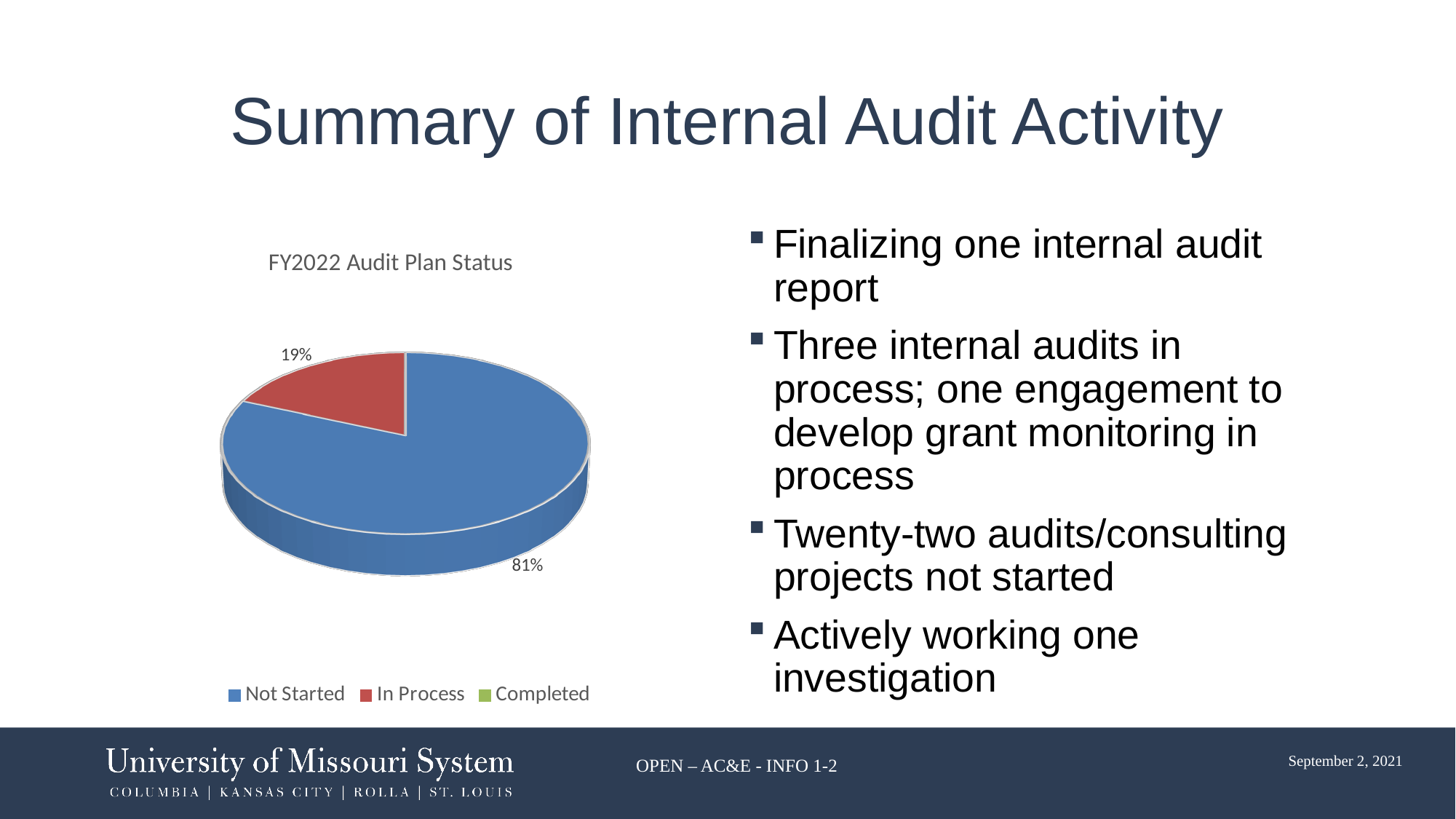
Which is larger, the Not Started slice or the In Process slice? Not Started How many entries does the legend list? 3 What share of the pie is labelled Not Started? 81% Which category has the largest slice of the pie? Not Started What is the difference in percentage points between the Not Started and In Process slices? 62 Which legend entry is shown in red? In Process What is the title of the chart? FY2022 Audit Plan Status Is the share for In Process greater or less than 25%? less Is the share for Not Started greater or less than 50%? greater What type of chart is shown on the slide? pie chart What share of the pie is labelled In Process? 19%